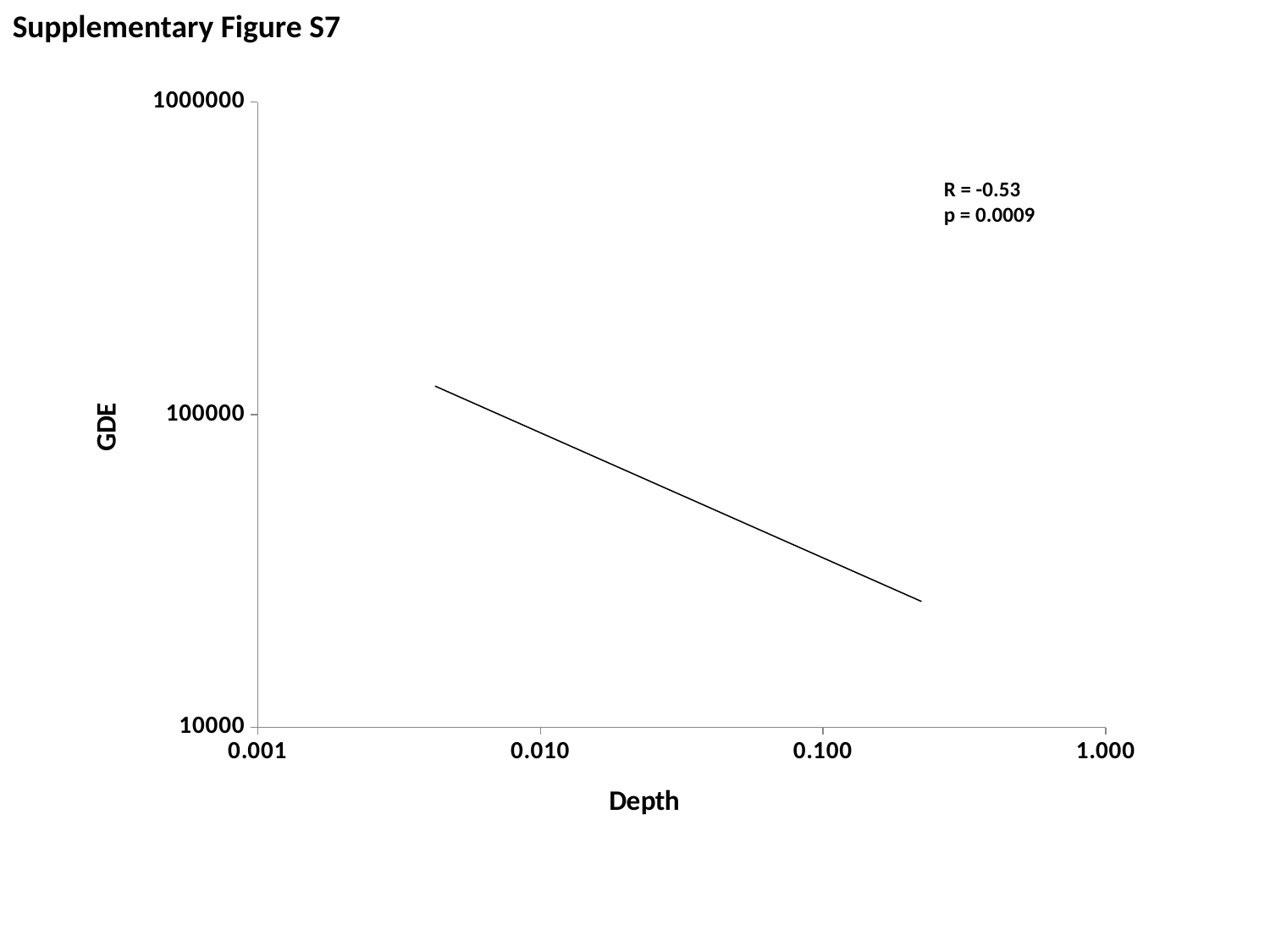
Is the value of the line at a Depth of 0.010 greater or less than 100000? less What is the correlation coefficient R printed on the chart? R = -0.53 What is the highest tick value shown on the y axis? 1000000 What is the label of the y axis? GDE Is the GDE value at the left end of the line greater or less than 100000? greater What p value is printed on the chart? p = 0.0009 Is the value of the line at a Depth of 0.100 greater or less than 100000? less What kind of chart is shown on the slide? line chart Is the GDE value at the left end of the line larger or smaller than the value at the right end? larger What is the label of the x axis? Depth Does the line rise or fall as Depth increases along the x axis? fall